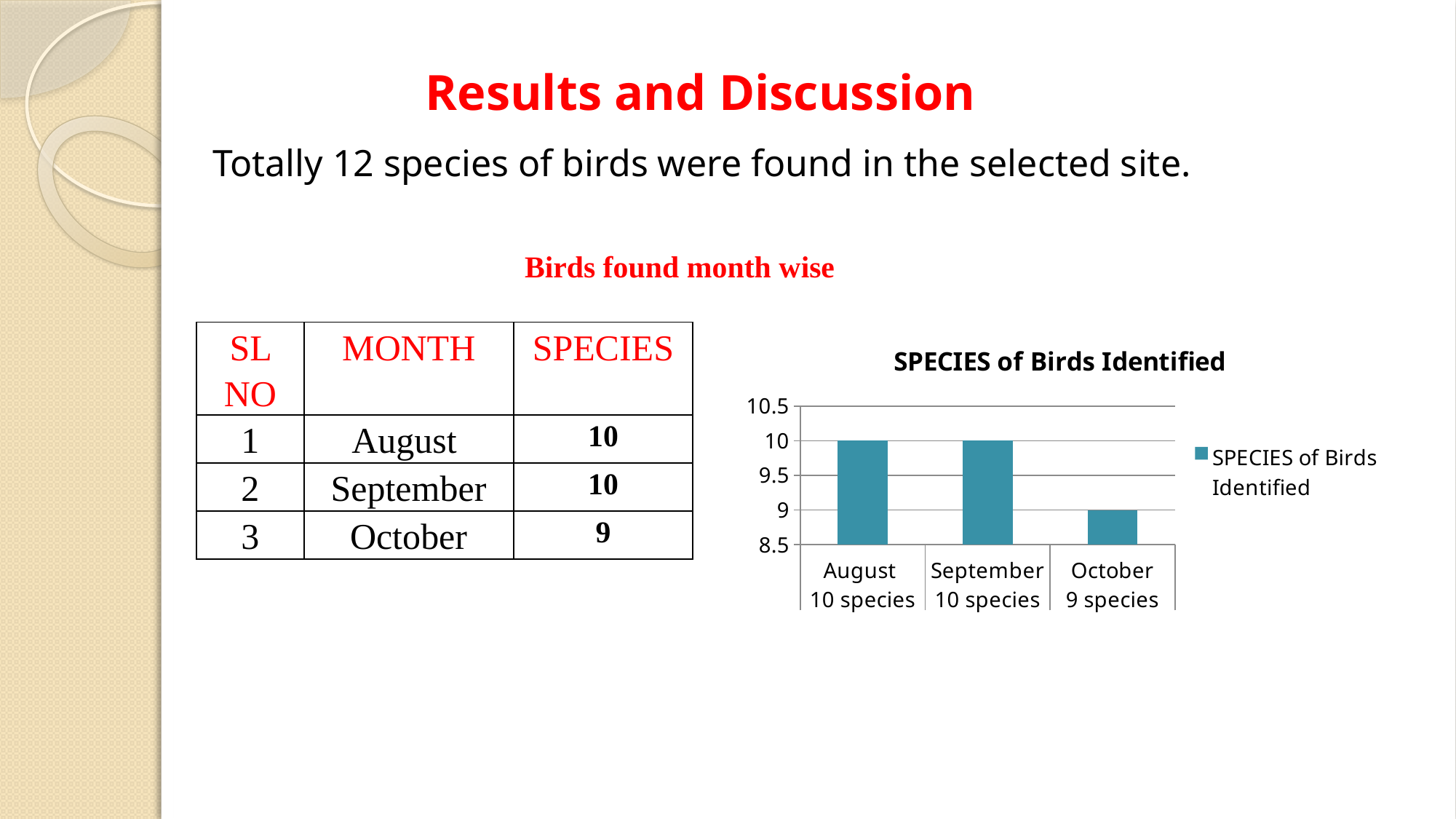
How many series does the chart legend list? 1 Which is larger, the value for September or the value for October? September What is the value for August in the chart? 10 What is the value for October in the chart? 9 What is the difference between the values for August and October? 1 Is the value for October greater or less than 9.5? less What is the value for September in the chart? 10 What is the title of the chart? SPECIES of Birds Identified Which month has the lowest value in the chart? October What type of chart is shown on the slide? bar chart How many categories are shown on the x axis of the chart? 3 Do the values rise or fall from September to October? fall